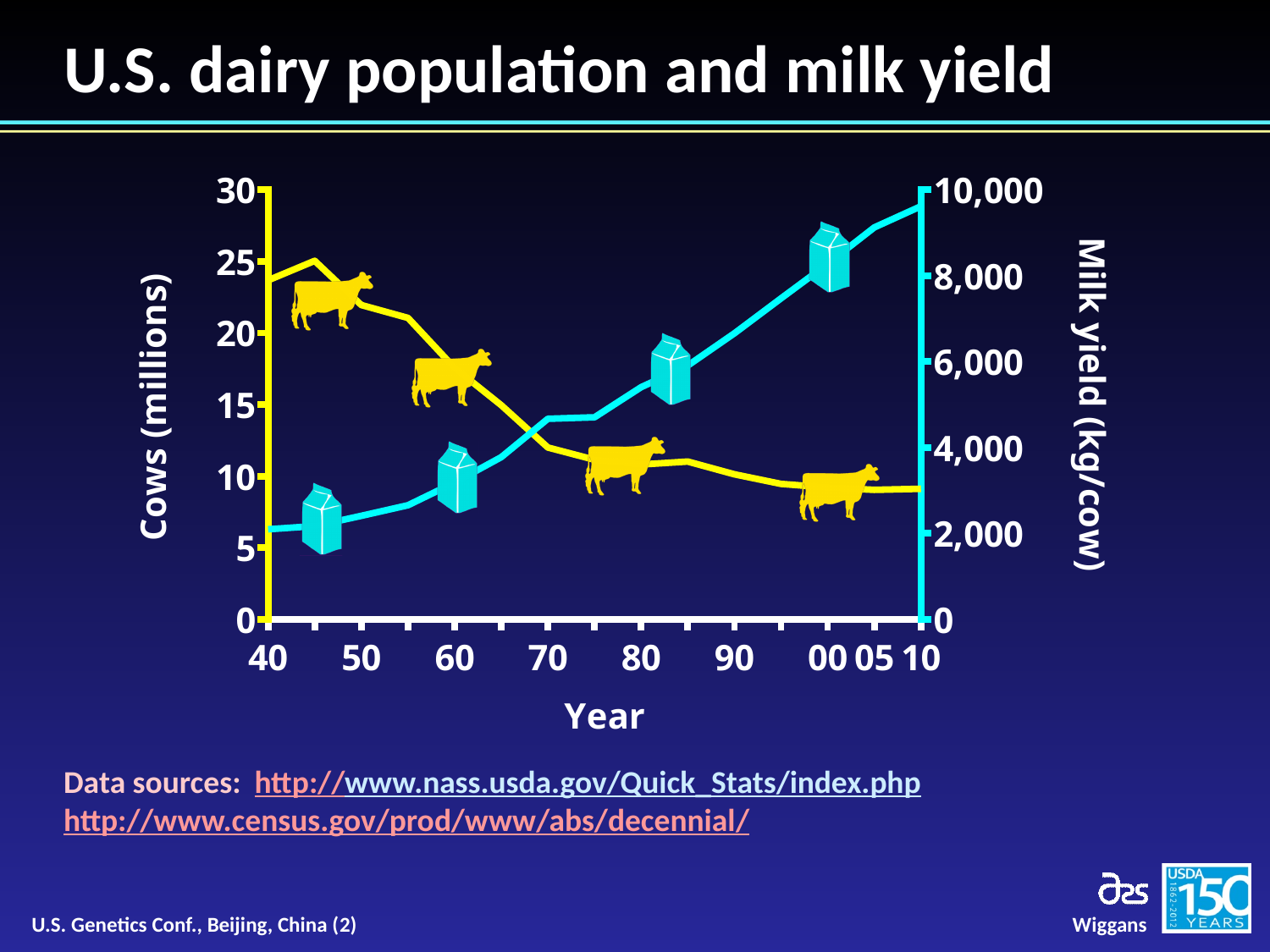
Which year has the higher number of cows, 1940 or 2010? 1940 What is the title of the left vertical axis? Cows (millions) Is the milk yield per cow in 2010 greater or less than 8,000 kg? greater Is the number of cows in 1940 greater or less than 20 million? greater Is the number of cows in 1980 greater or less than 15 million? less What is the title of the right vertical axis? Milk yield (kg/cow) How does milk yield per cow (cyan line) change from 1940 to 2010? rises Which year has the higher milk yield per cow, 1960 or 2000? 2000 How does the number of cows (yellow line) change from 1940 to 2010? falls What kind of chart is shown on the slide? line chart